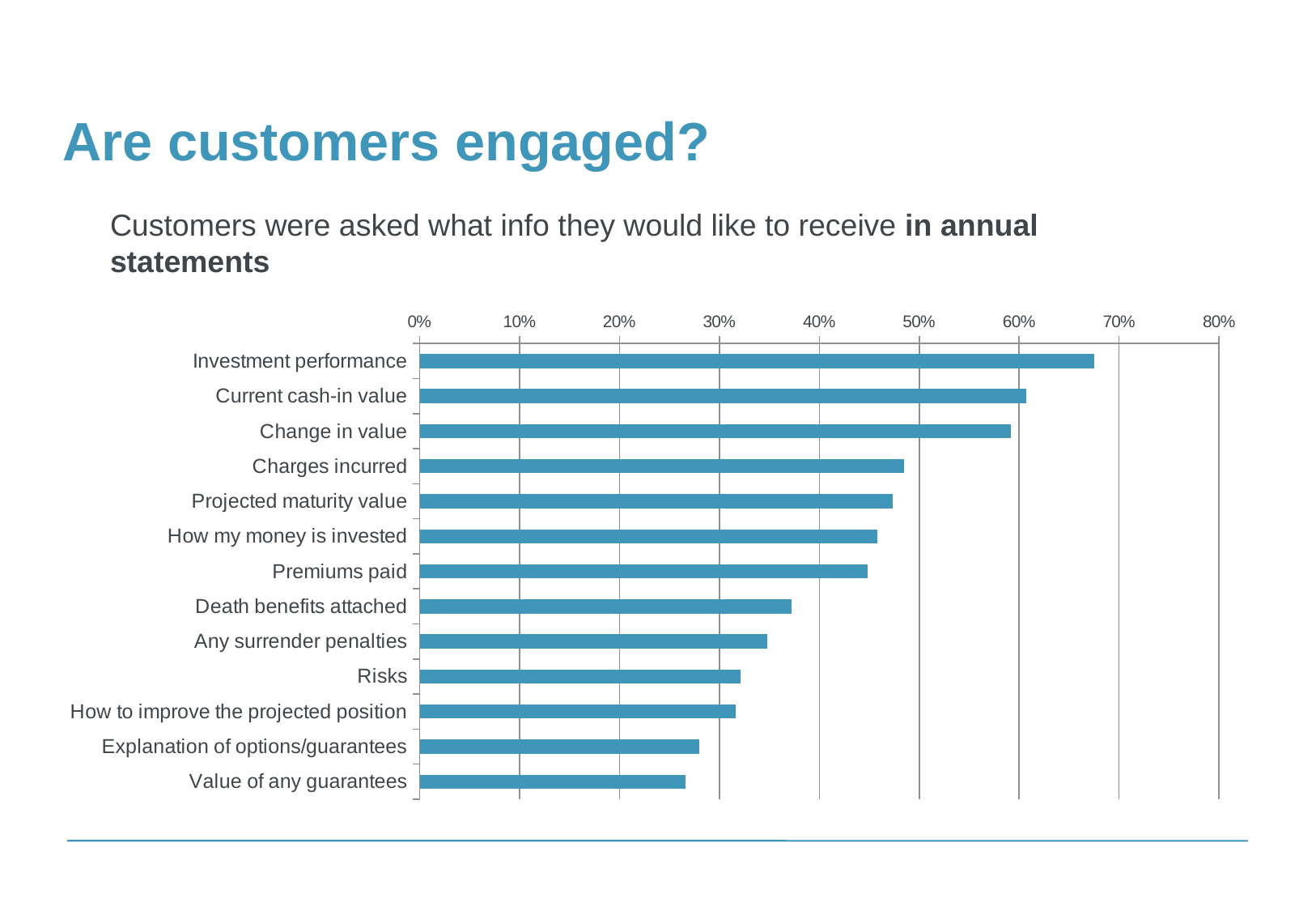
Which category has the lowest value in the chart? Value of any guarantees Which has a larger value, Any surrender penalties or Change in value? Change in value Is the value for Investment performance greater or less than 60%? greater Is the value for Death benefits attached greater or less than 30%? greater What kind of chart is shown on the slide? bar chart Which has a larger value, Current cash-in value or Premiums paid? Current cash-in value Is the value for Charges incurred greater or less than 40%? greater What is the highest value shown on the chart's percentage axis? 80% Which category has the highest value in the chart? Investment performance How many categories are plotted in the chart? 13